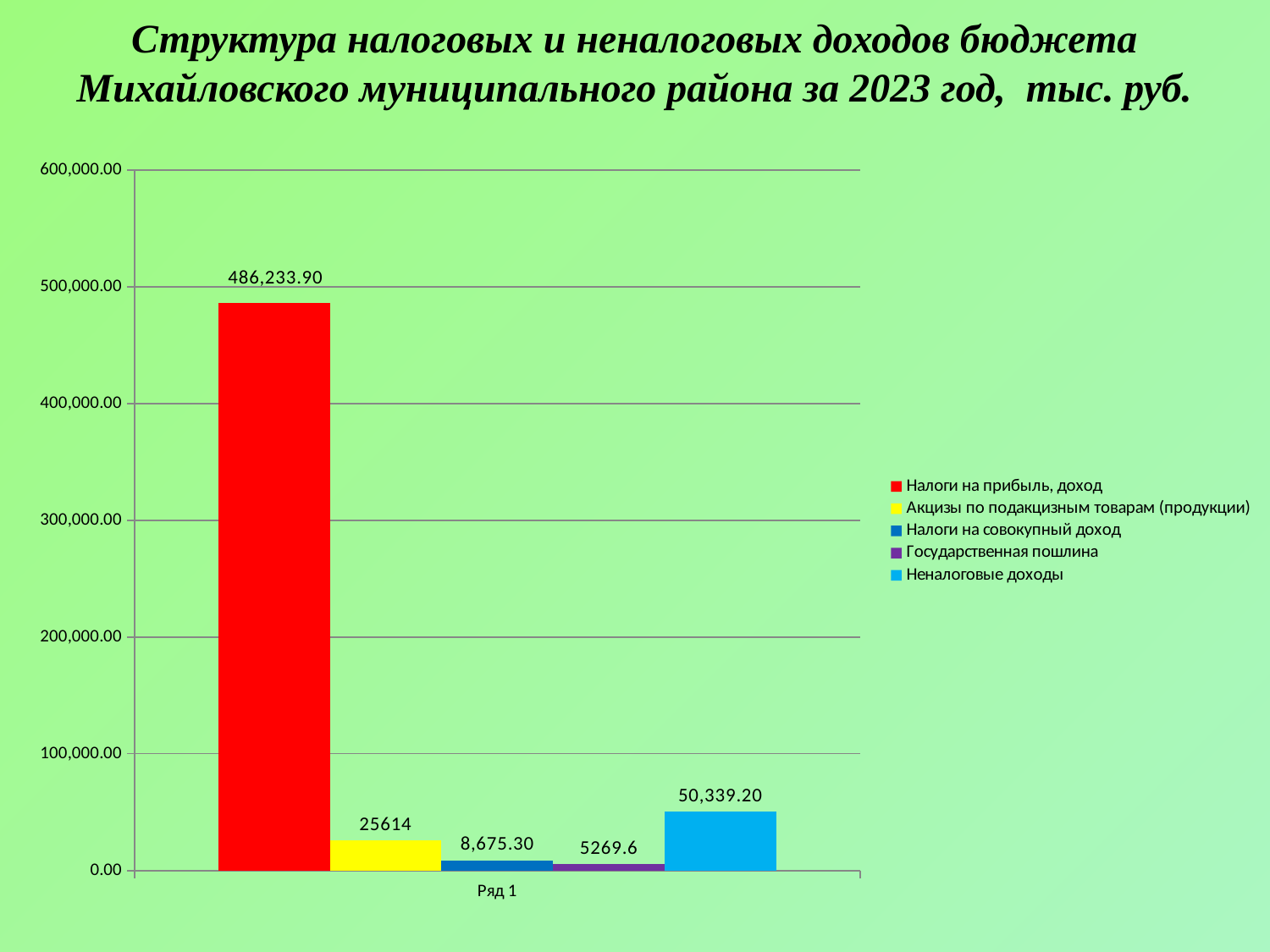
What colour is the bar for Неналоговые доходы? light blue How many series does the legend list? 5 Which series has the lowest value? Государственная пошлина What is the value for Неналоговые доходы? 50,339.20 What is the value for Государственная пошлина? 5269.6 What is the difference between Неналоговые доходы and Акцизы по подакцизным товарам (продукции)? 24,725.20 What is the value for Налоги на прибыль, доход? 486,233.90 What is the value for Акцизы по подакцизным товарам (продукции)? 25614 Which series has the highest value? Налоги на прибыль, доход Is the value for Налоги на прибыль, доход greater or less than 400,000.00? greater Which is larger, Налоги на совокупный доход or Государственная пошлина? Налоги на совокупный доход What kind of chart is shown on the slide? bar chart